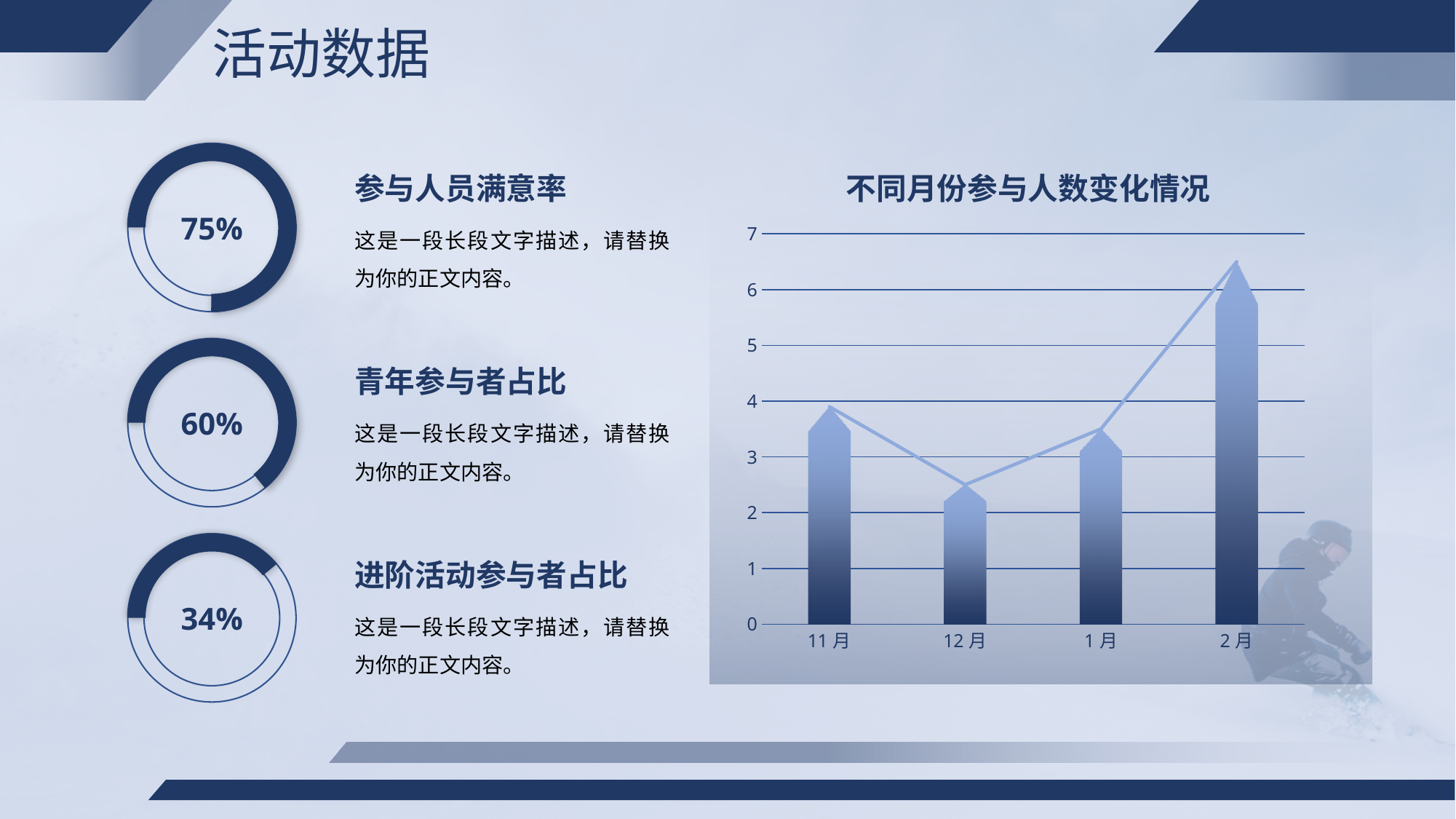
In the 不同月份参与人数变化情况 chart, is the bar value for 12月 greater or less than 3? less How many months are shown on the x axis of the 不同月份参与人数变化情况 chart? 4 In the 不同月份参与人数变化情况 chart, is the bar value for 2月 greater or less than 5? greater In the 不同月份参与人数变化情况 chart, do the values rise or fall from 12月 to 2月? rise In the 不同月份参与人数变化情况 chart, is the bar for 11月 or 12月 taller? 11月 What is the highest value shown on the y axis of the 不同月份参与人数变化情况 chart? 7 In the 不同月份参与人数变化情况 chart, which month has the lowest bar? 12月 In the 不同月份参与人数变化情况 chart, which month has the highest bar? 2月 In the 不同月份参与人数变化情况 chart, is the bar value for 11月 greater or less than 3? greater In the 不同月份参与人数变化情况 chart, is the bar for 2月 or 1月 taller? 2月 What kind of chart is 不同月份参与人数变化情况? bar chart with a line What is the title of the chart on the right side of the slide? 不同月份参与人数变化情况